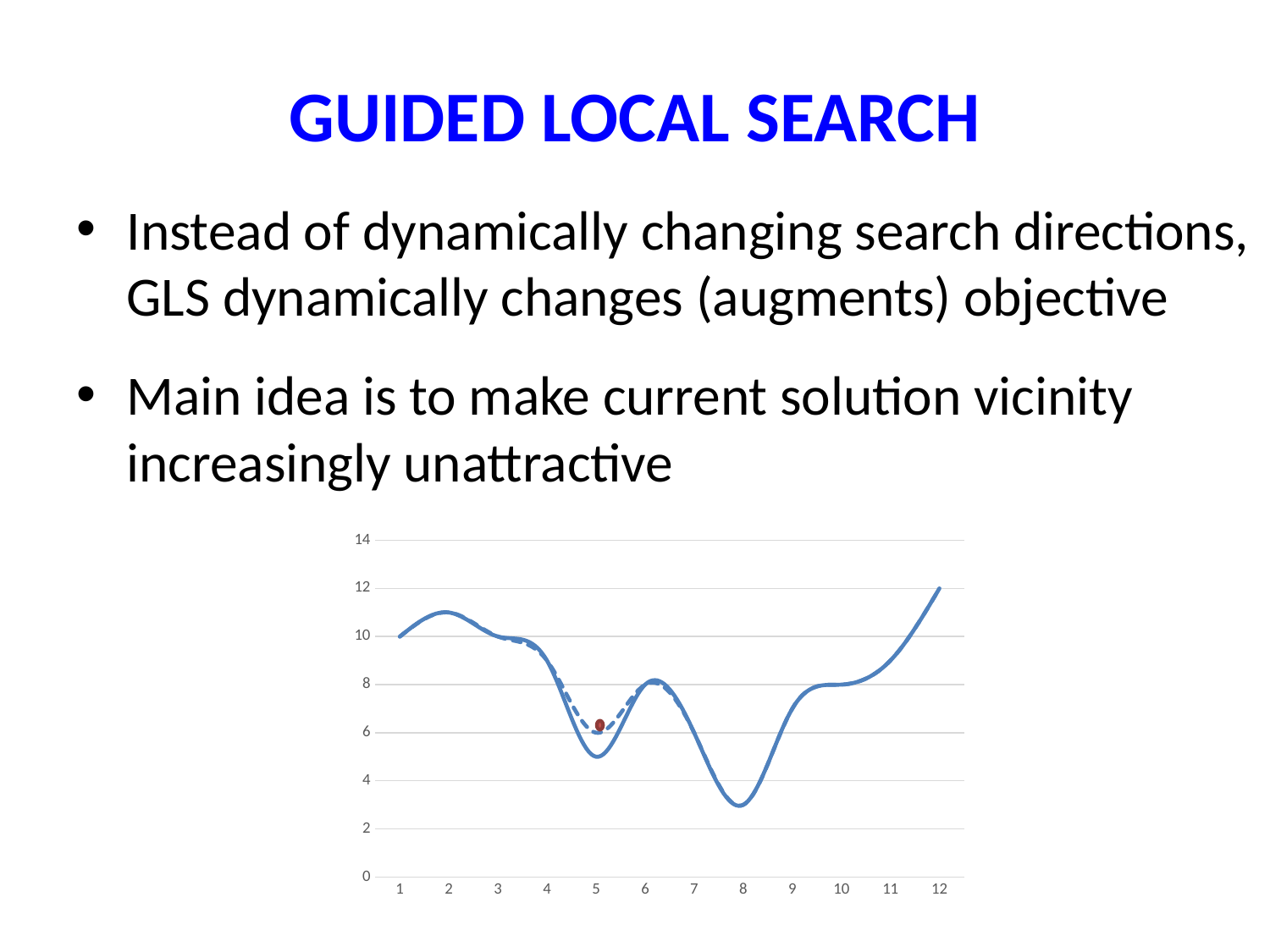
What is the value of the solid line at x = 1? 10 What kind of chart is shown on the slide? line chart Which is larger, the value of the solid line at x = 2 or at x = 8? x = 2 At which x-axis value does the solid line reach its lowest point? 8 At which x-axis value does the solid line reach its highest point? 12 Is the value of the solid line at x = 8 greater or less than 4? less What is the value of the solid line at x = 12? 12 Is the value of the solid line at x = 2 greater or less than 10? greater Does the solid line rise or fall between x = 8 and x = 12? rise Is the value of the solid line at x = 11 greater or less than 8? greater How many points are labelled along the x axis of the chart? 12